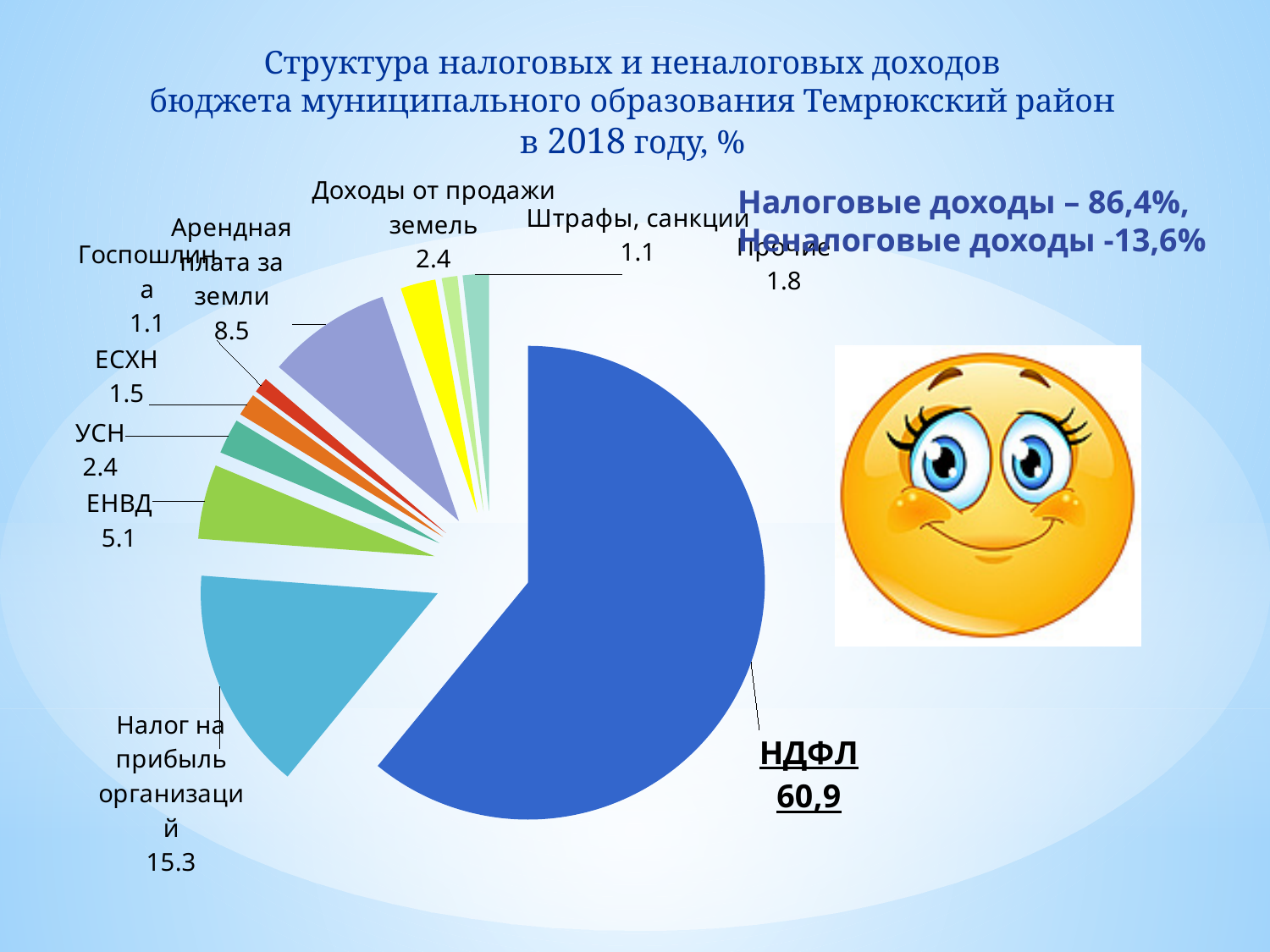
According to the text on the slide, what is the share of Налоговые доходы? 86,4% What is the value for Налог на прибыль организаций? 15.3 What is the difference between Налог на прибыль организаций and Арендная плата за земли? 6.8 Which is larger, ЕНВД or УСН? ЕНВД What is the value for Арендная плата за земли? 8.5 How many slices does the pie chart have? 10 What is the value for Прочие? 1.8 What kind of chart is shown on the slide? pie chart Which category has the largest slice of the pie? НДФЛ What is the value for ЕНВД? 5.1 What is the value for НДФЛ in the pie chart? 60,9 What share of the pie does НДФЛ hold? 60,9%